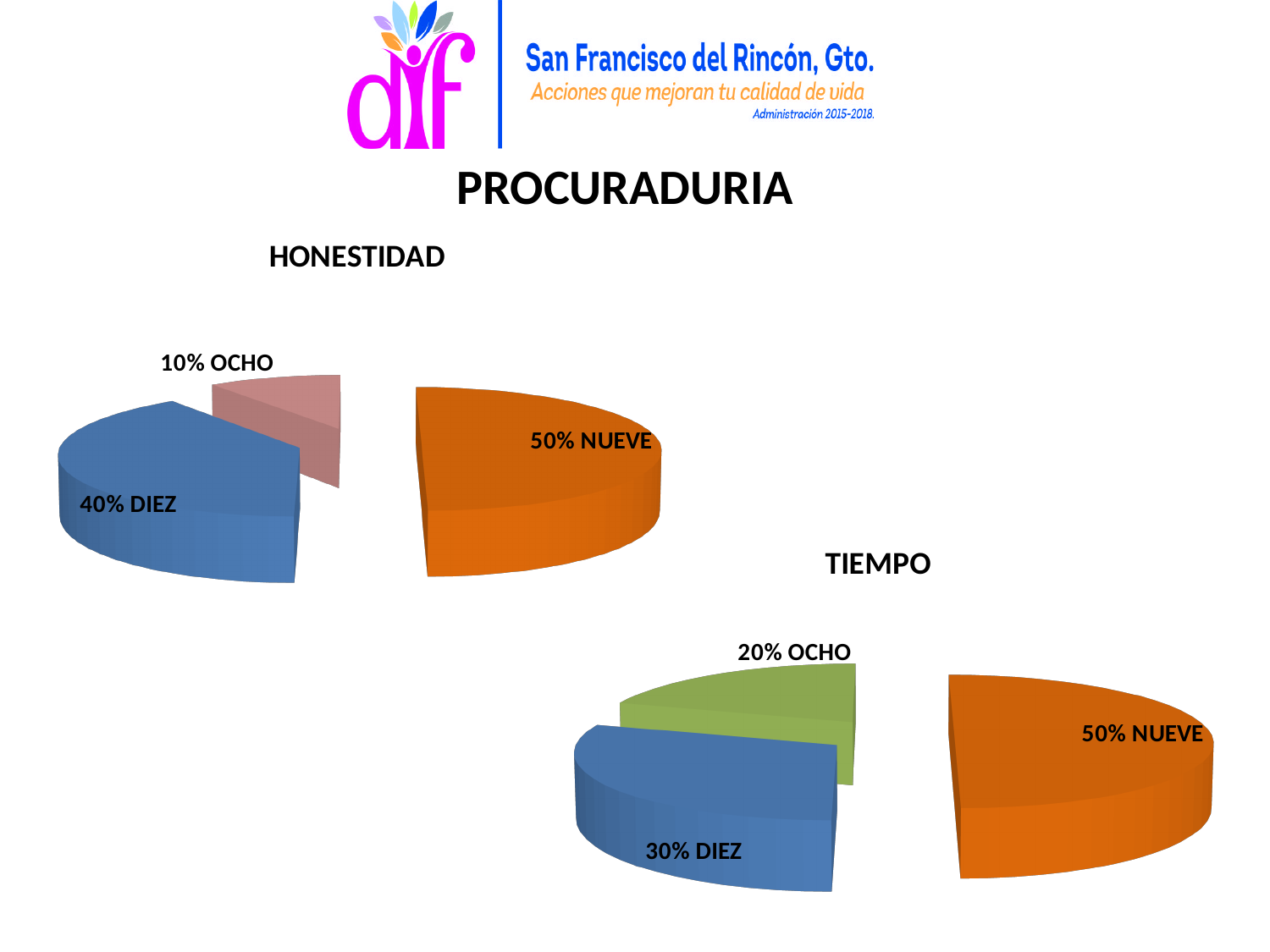
In the HONESTIDAD chart, which is larger, the DIEZ slice or the OCHO slice? DIEZ In the HONESTIDAD chart, how many slices are there? 3 In the HONESTIDAD chart, what share does the DIEZ slice have? 40% In the TIEMPO chart, what share does the OCHO slice have? 20% What kind of chart is the TIEMPO chart? Pie chart In the TIEMPO chart, what share does the DIEZ slice have? 30% In the TIEMPO chart, which category has the largest slice? NUEVE In the TIEMPO chart, what is the difference in percentage points between the DIEZ and OCHO slices? 10% In the HONESTIDAD chart, which category has the smallest slice? OCHO In the HONESTIDAD chart, which category has the largest slice? NUEVE